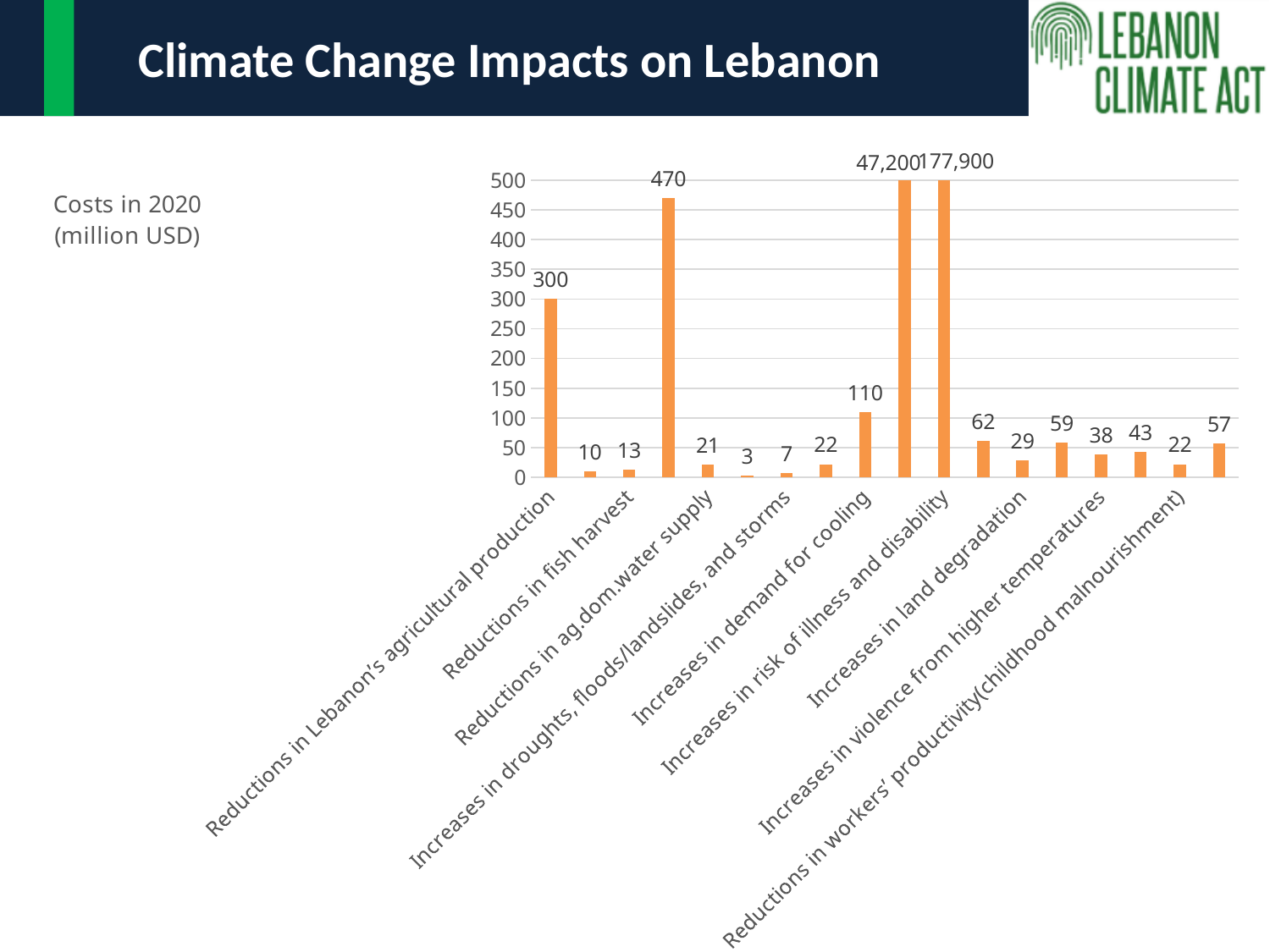
What is the difference between the two largest labeled values, 177,900 and 47,200? 130,700 What is the value for Reductions in Lebanon's agricultural production? 300 What is the highest tick value shown on the vertical axis? 500 What is the smallest value labeled on the chart? 3 Which is larger: the value labeled 470 or the value labeled 300? 470 How many bars are plotted in the chart? 18 What kind of chart is shown on the slide? bar chart What is the value shown on the first bar of the chart? 300 What is the largest value labeled on the chart? 177,900 Is the value for Reductions in Lebanon's agricultural production greater or less than 250? greater In what unit are the costs on the chart expressed? million USD